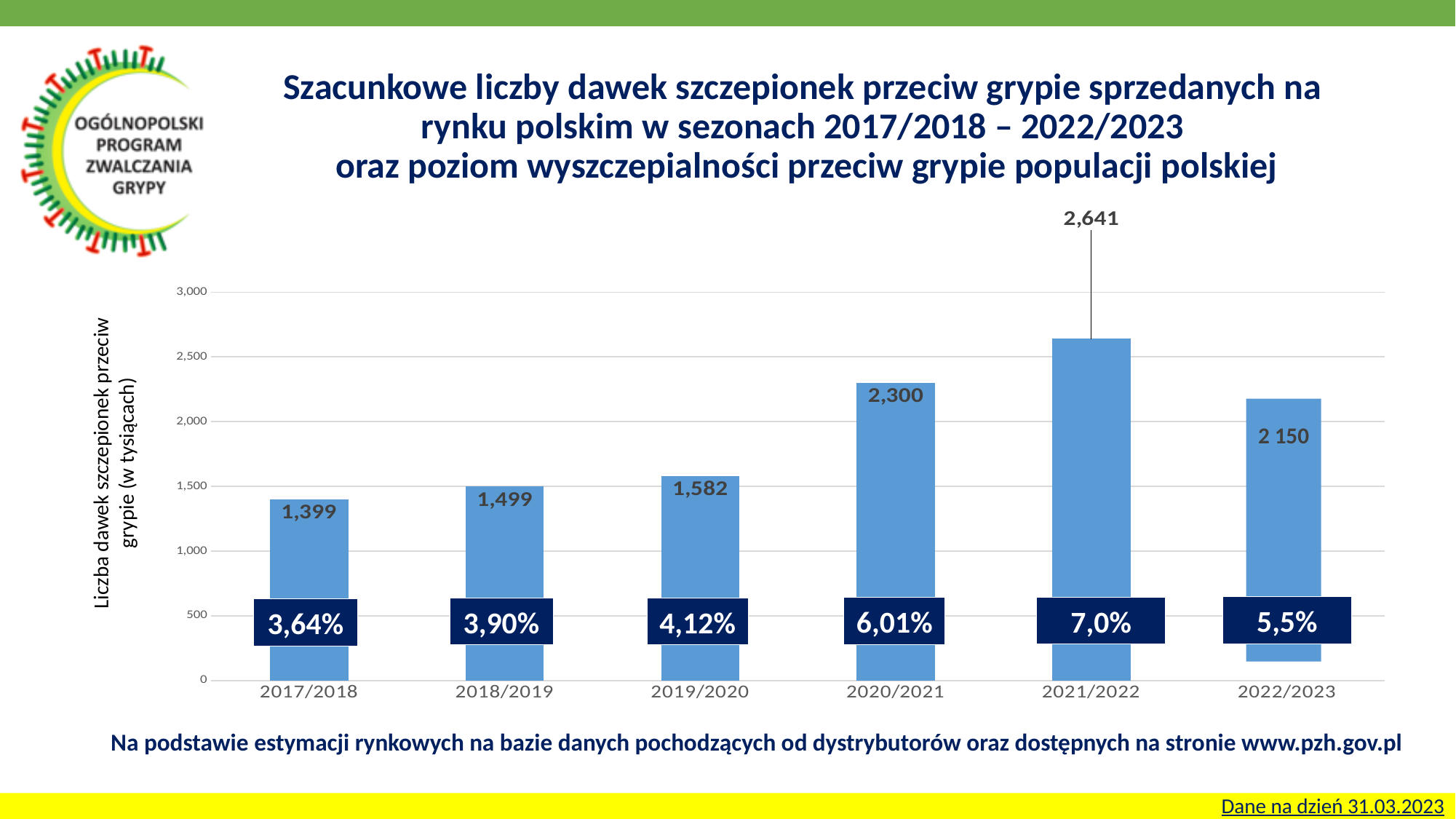
Do the doses sold rise or fall from the 2017/2018 season to the 2021/2022 season? rise Is the value for 2019/2020 greater or less than 2,000? less Which season has the highest number of doses sold? 2021/2022 What is the difference in doses (in thousands) between the 2020/2021 and 2019/2020 seasons? 718 Which season had more doses sold, 2018/2019 or 2022/2023? 2022/2023 Which season has the lowest number of doses sold? 2017/2018 How many seasons are shown on the x axis of the chart? 6 What is the number of flu vaccine doses (in thousands) sold in the 2022/2023 season? 2 150 What is the number of flu vaccine doses (in thousands) sold in the 2021/2022 season? 2,641 What is the number of flu vaccine doses (in thousands) sold in the 2017/2018 season? 1,399 What vaccination coverage percentage is shown for the 2020/2021 season? 6,01% What kind of chart is shown on the slide? bar chart